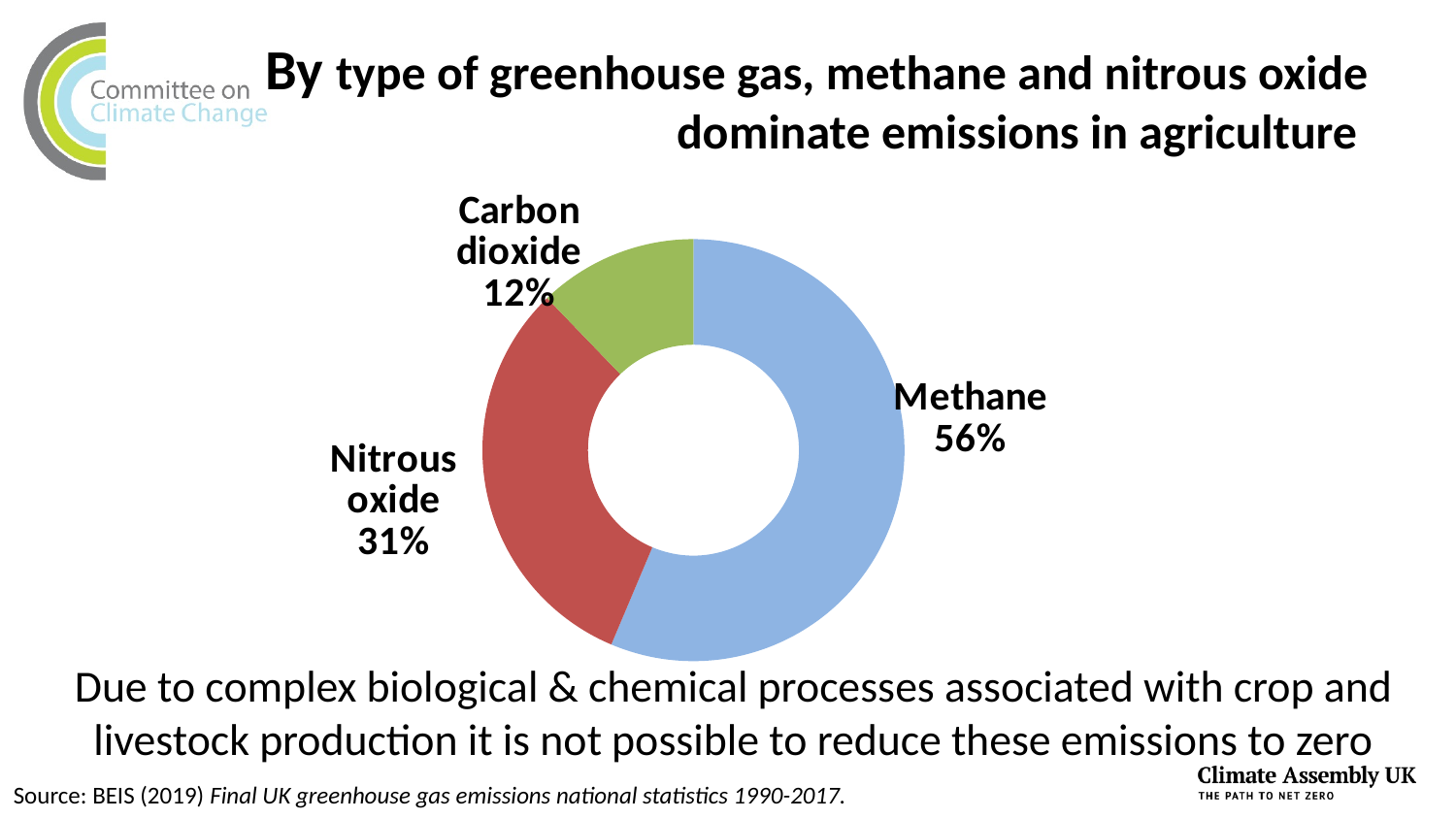
What share of agricultural emissions comes from methane? 56% What colour is the methane segment of the chart? Blue How many greenhouse gas categories are shown in the chart? 3 What is the difference in percentage points between the methane and nitrous oxide shares? 25 percentage points What share of agricultural emissions comes from carbon dioxide? 12% What kind of chart is shown on the slide? Doughnut (pie) chart What is the difference in percentage points between the nitrous oxide and carbon dioxide shares? 19 percentage points Which greenhouse gas has the largest share of agricultural emissions? Methane What share of agricultural emissions comes from nitrous oxide? 31% Which has a larger share of agricultural emissions, nitrous oxide or carbon dioxide? Nitrous oxide What colour is the nitrous oxide segment of the chart? Red Which greenhouse gas has the smallest share of agricultural emissions? Carbon dioxide